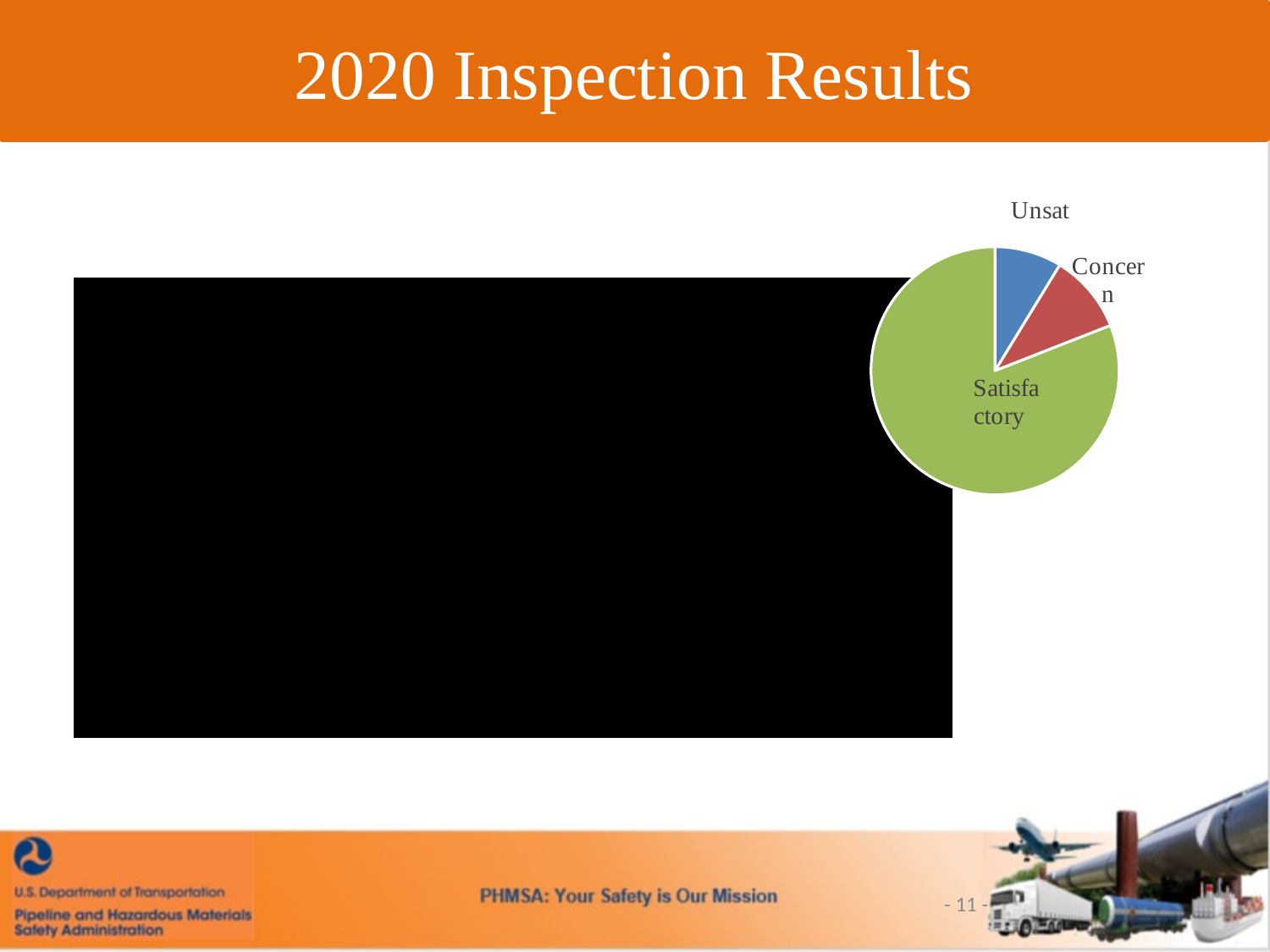
What colour is the Satisfactory slice of the pie chart? green Which category has the largest slice of the pie chart? Satisfactory Which slice is larger, Concern or Unsat? Concern What is the title of the slide containing the pie chart? 2020 Inspection Results Which slice is larger, Satisfactory or Concern? Satisfactory Which category has the smallest slice of the pie chart? Unsat What kind of chart is shown on the slide? pie chart How many slices does the pie chart have? 3